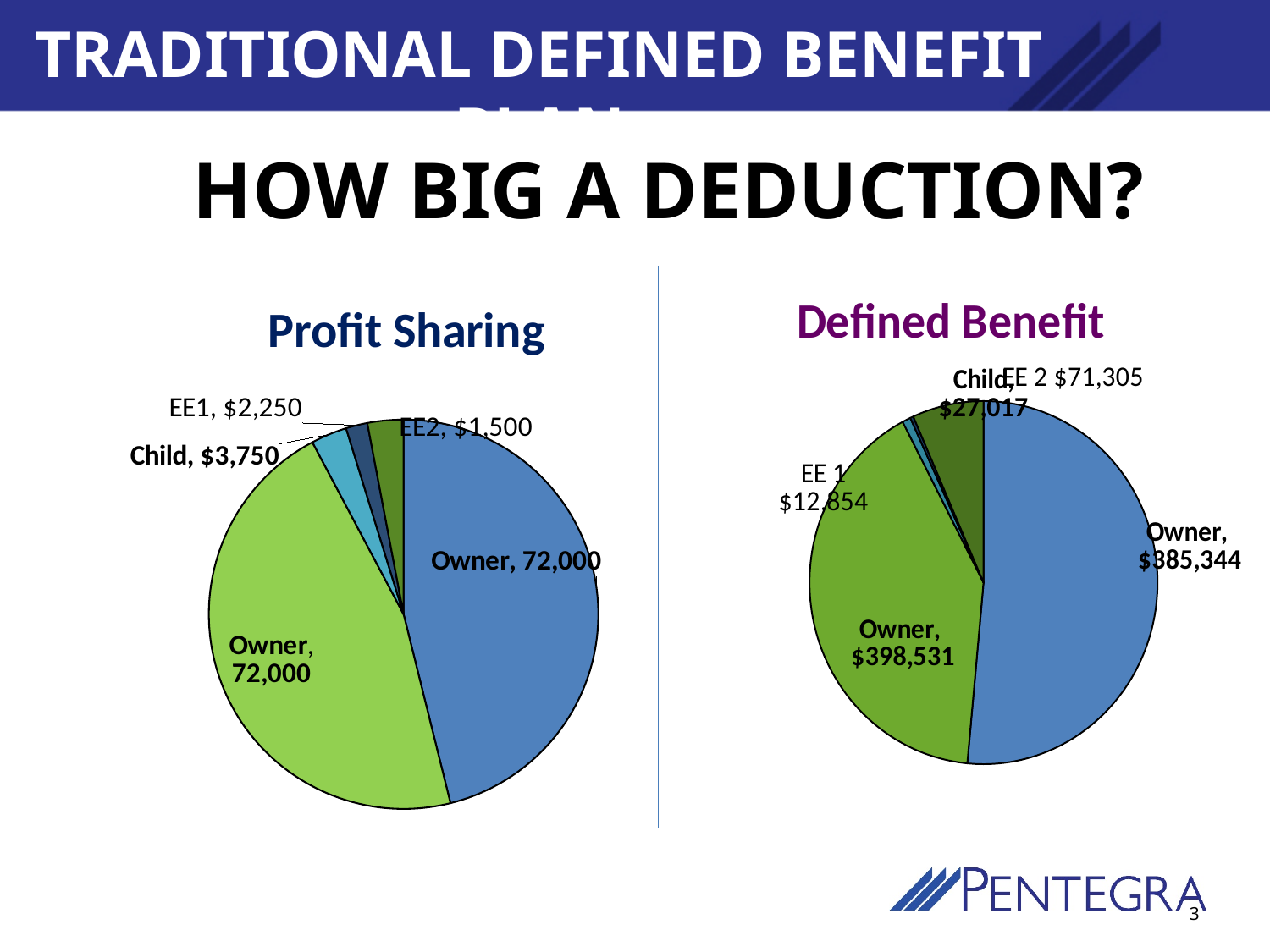
What is the title of the chart on the right side of the slide? Defined Benefit In the Defined Benefit chart, which is larger, the EE 2 slice or the Child slice? EE 2 How many slices does the Profit Sharing pie chart have? 5 In the Defined Benefit chart, which slice is the smallest? EE 1, $12,854 In the Profit Sharing chart, what is the difference between the Child value and the EE1 value? $1,500 In the Defined Benefit chart, what is the value for EE 1? $12,854 In the Defined Benefit chart, what is the difference between the two Owner slices ($398,531 and $385,344)? $13,187 In the Defined Benefit chart, what is the value for EE 2? $71,305 In the Profit Sharing chart, what is the value for EE1? $2,250 What type of chart is the Profit Sharing chart? pie chart In the Profit Sharing chart, what is the value for Child? $3,750